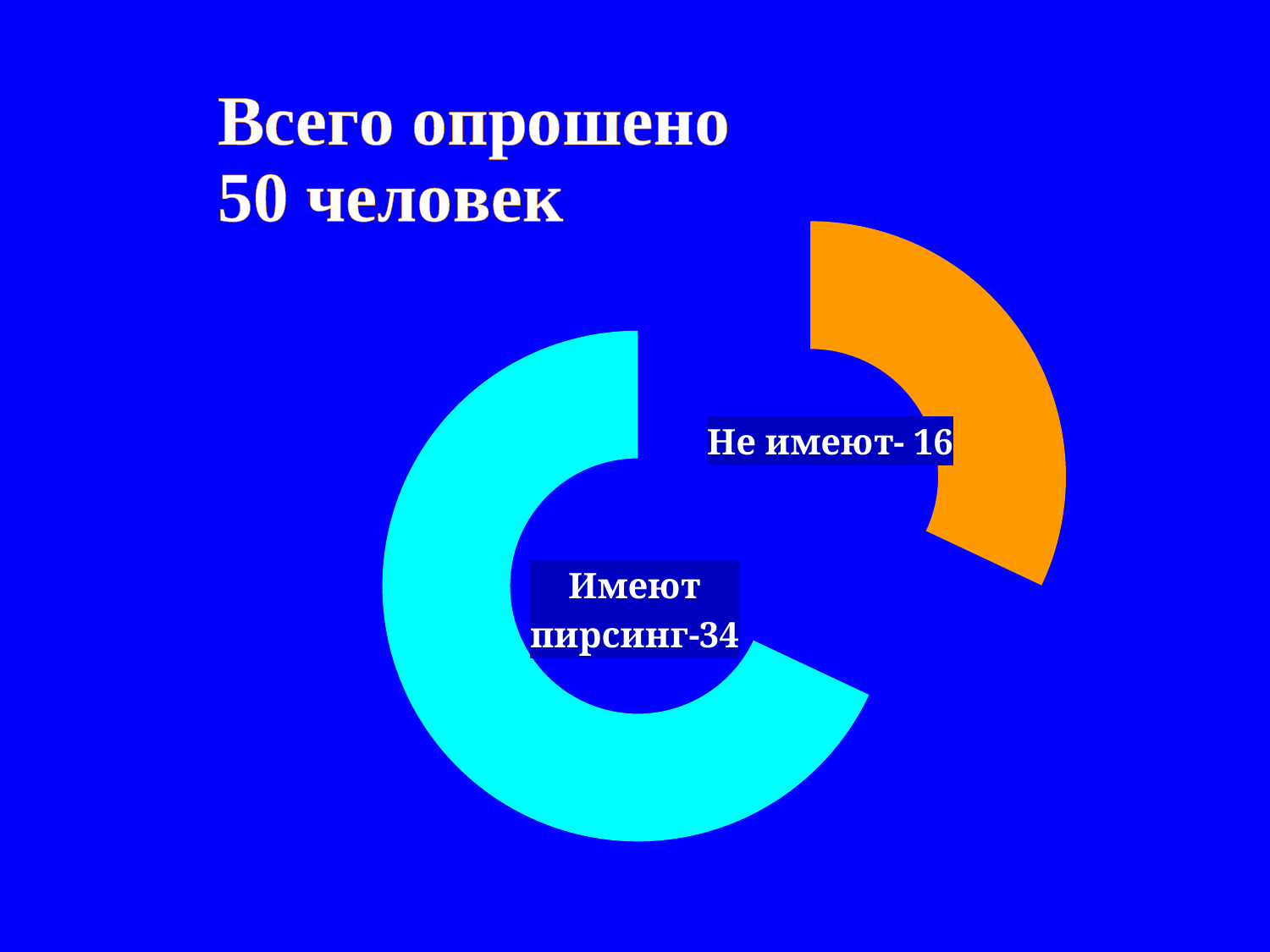
How many people do not have piercings (Не имеют) according to the chart? 16 What share of the total does the Имеют пирсинг segment represent? 68% Which category has the larger value, Имеют пирсинг or Не имеют? Имеют пирсинг What share of the total does the Не имеют segment represent? 32% What kind of chart is shown on the slide? Doughnut (pie) chart How many categories are shown in the chart? 2 According to the slide text, how many people were surveyed in total? 50 человек What is the difference between the number who have piercings and the number who do not? 18 How many people have piercings (Имеют пирсинг) according to the chart? 34 What is the total of the two categories shown in the chart? 50 Which category has the smallest value in the chart? Не имеют What colour is the Не имеют segment? Orange